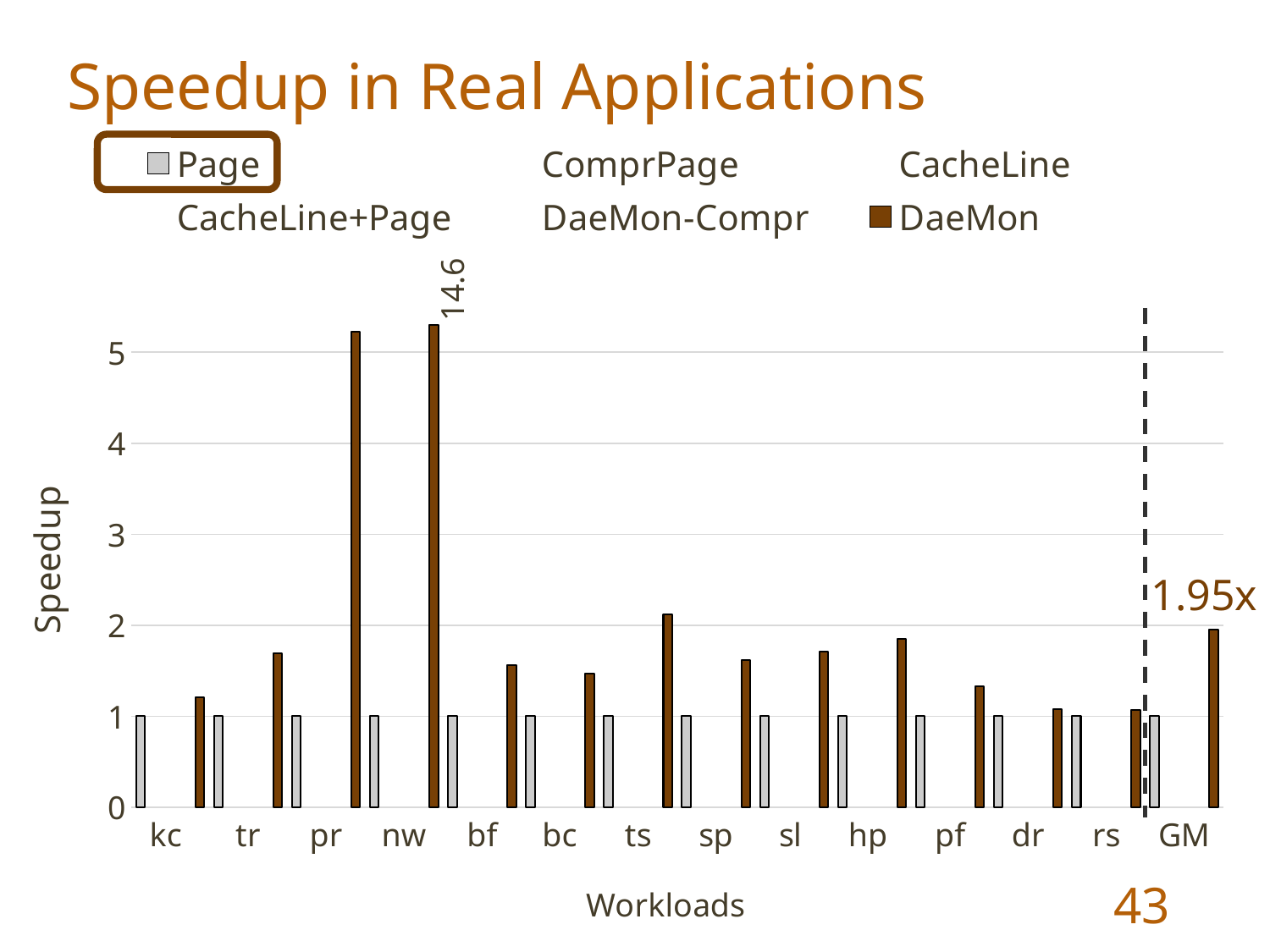
What is the DaeMon speedup for the nw workload? 14.6 Is the DaeMon speedup for pr greater or less than 4? greater How many series does the legend list? 6 Which has the larger DaeMon speedup, tr or pf? tr Is the DaeMon speedup for dr greater or less than 2? less Which workload has the highest DaeMon speedup? nw What kind of chart is shown on the slide? bar chart What is the DaeMon speedup for GM? 1.95x How many workload categories are shown on the x axis? 14 What is the title of the y axis? Speedup Which has the larger DaeMon speedup, hp or bc? hp What is the Page speedup for the kc workload? 1